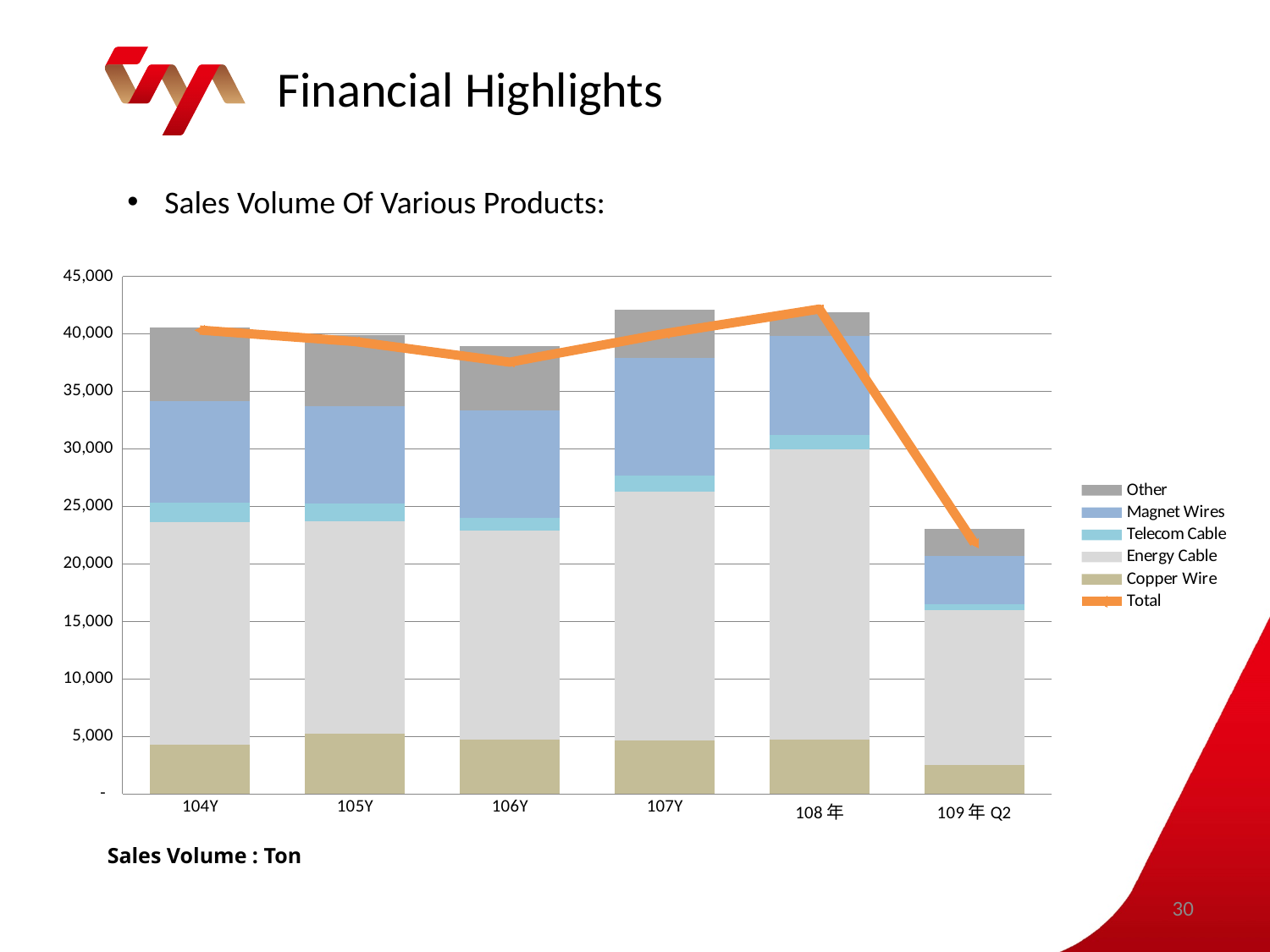
How many series does the legend list? 6 Does the Total line rise or fall from 108年 to 109年 Q2? Fall What kind of chart is shown on the slide? Stacked bar chart with a line for Total Is the total sales volume for 109年 Q2 greater or less than 25,000? less Which has the larger total sales volume, 104Y or 109年 Q2? 104Y What unit is the sales volume measured in, according to the label below the chart? Ton What colour is the Total line in the chart? Orange How many categories are shown along the x axis? 6 Which has the larger Copper Wire sales volume, 104Y or 109年 Q2? 104Y Which category has the lowest total sales volume? 109年 Q2 Is the total sales volume for 106Y greater or less than 40,000? less